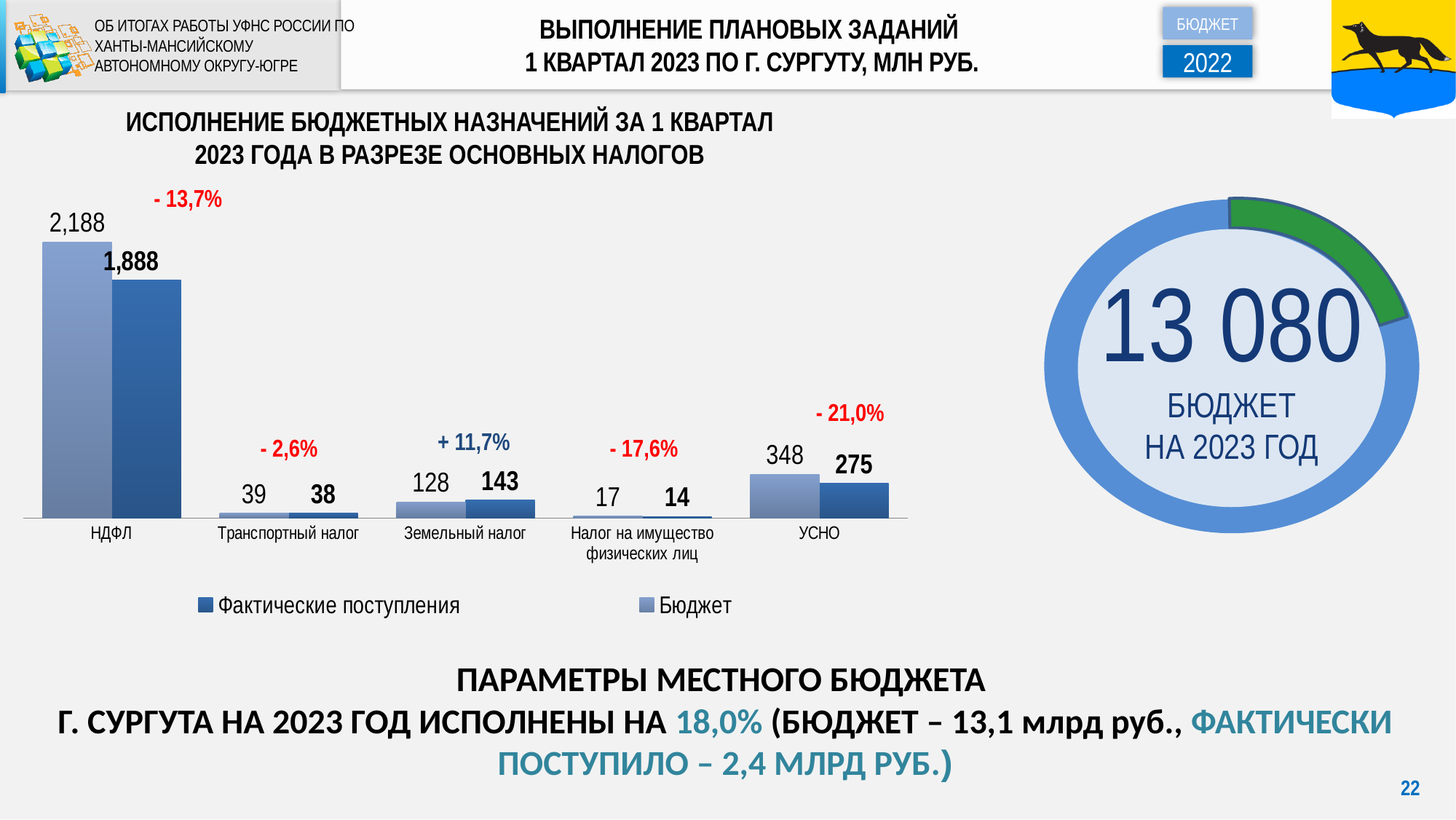
In the bar chart, which is larger for Земельный налог: Бюджет or Фактические поступления? Фактические поступления In the bar chart, what is the Бюджет value for НДФЛ? 2,188 How many categories are shown on the x axis of the bar chart? 5 How many series does the legend of the bar chart list? 2 In the bar chart, what is the difference between the Бюджет and Фактические поступления values for НДФЛ? 300 In the bar chart, what is the Бюджет value for Налог на имущество физических лиц? 17 In the bar chart, which category has the lowest Фактические поступления value? Налог на имущество физических лиц In the bar chart, what is the Фактические поступления value for Земельный налог? 143 What percentage change is shown above the УСНО bars in the bar chart? - 21,0% What kind of chart is used to show the budget assignments by tax? Bar chart In the bar chart, which category has the highest Бюджет value? НДФЛ In the bar chart, what is the Фактические поступления value for УСНО? 275